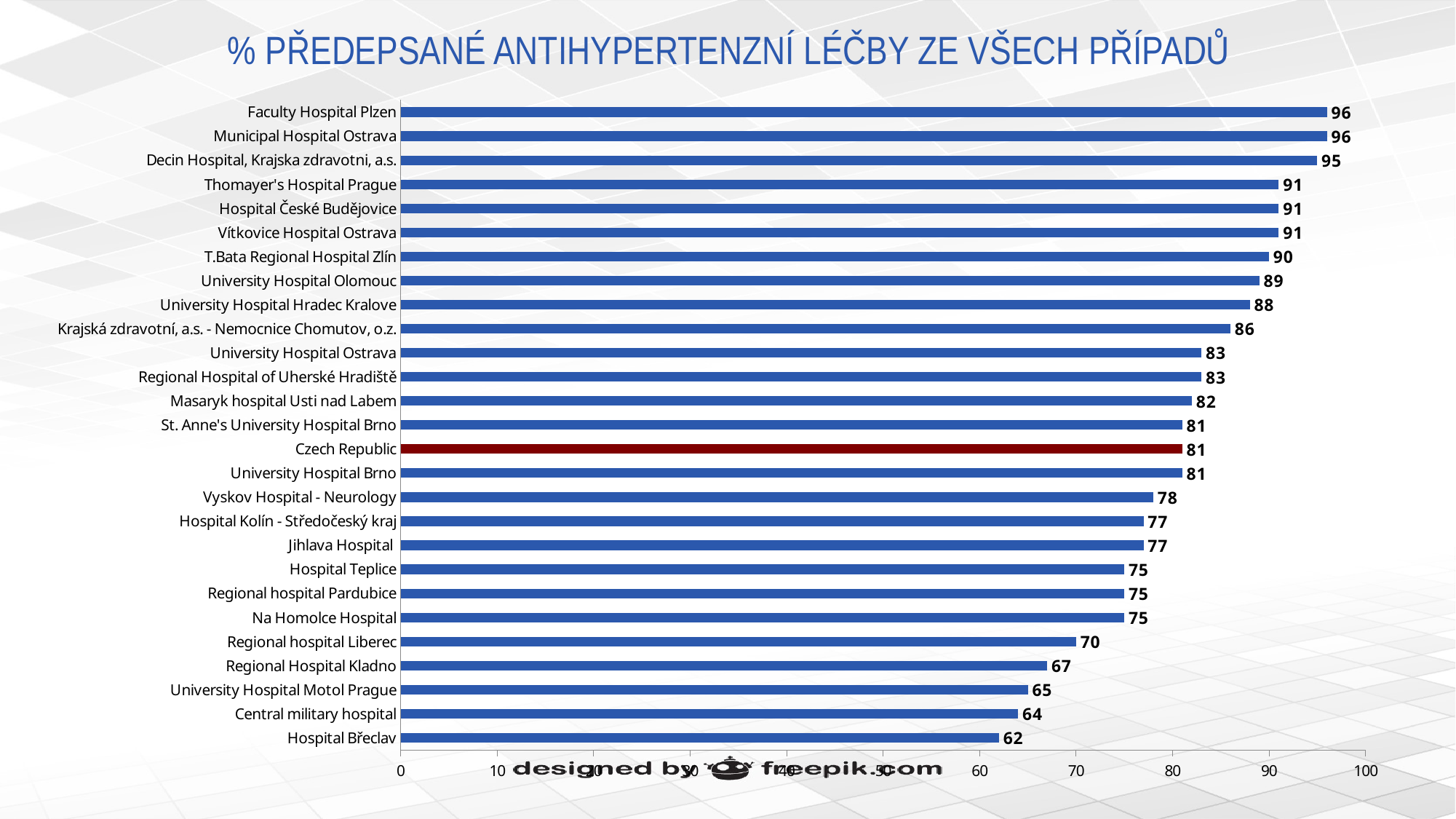
What is the value for Czech Republic? 81 What is the difference between the values for University Hospital Olomouc and Regional hospital Liberec? 19 Which category has the lowest value? Hospital Břeclav What is the value for University Hospital Motol Prague? 65 What is the difference between the values for Faculty Hospital Plzen and Hospital Břeclav? 34 How many categories are shown on the chart? 27 Is the value for Masaryk hospital Usti nad Labem greater or less than 90? less Which bar is shown in a different colour (dark red) from the others? Czech Republic What is the value for Decin Hospital, Krajska zdravotni, a.s.? 95 What is the value for Hospital Břeclav? 62 What kind of chart is shown on the slide? bar chart Which is larger, the value for Regional Hospital Kladno or the value for Vyskov Hospital - Neurology? Vyskov Hospital - Neurology